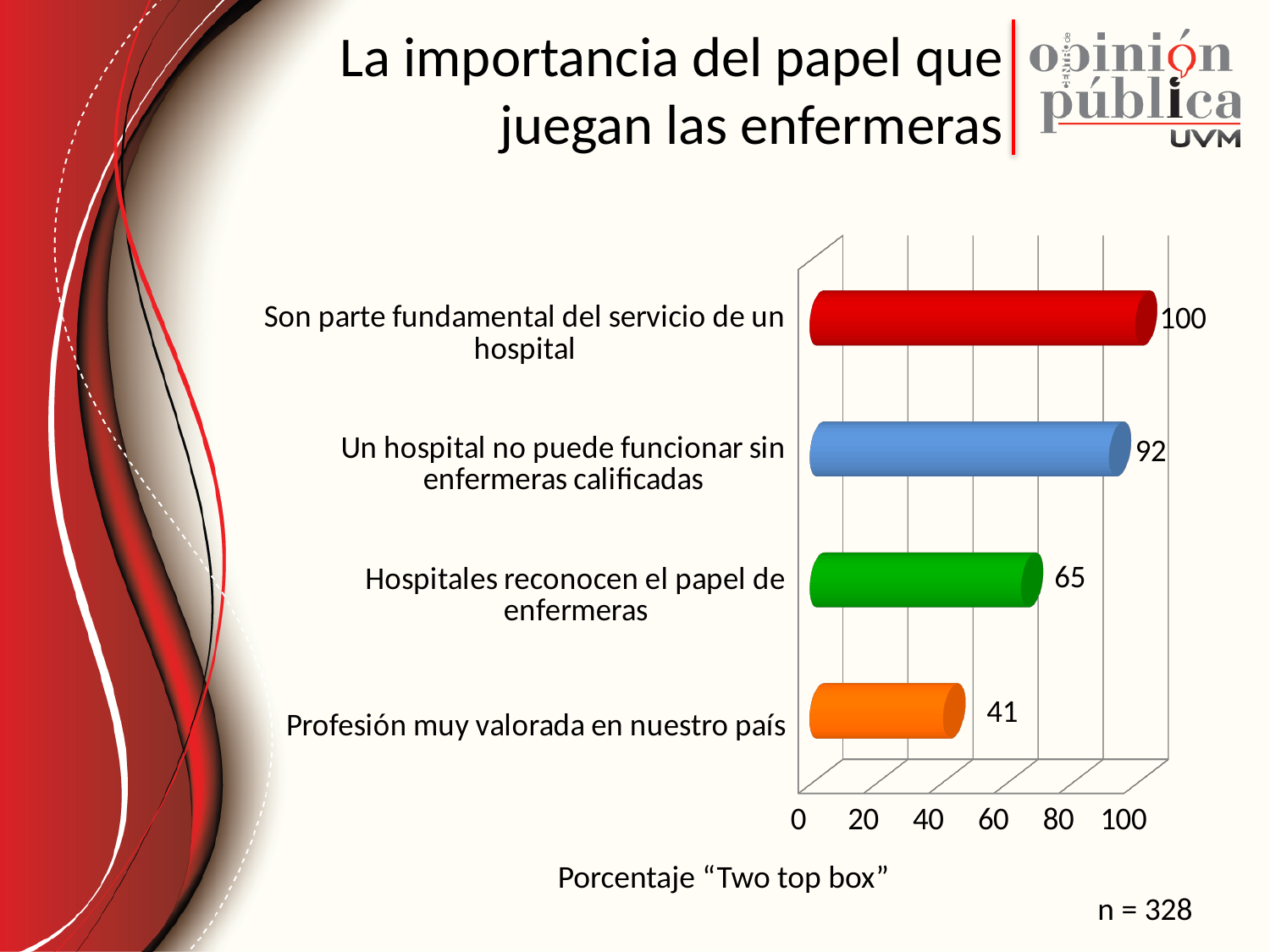
What is the value for "Hospitales reconocen el papel de enfermeras"? 65 Which is larger: the value for "Hospitales reconocen el papel de enfermeras" or the value for "Profesión muy valorada en nuestro país"? Hospitales reconocen el papel de enfermeras Which category has the highest value? Son parte fundamental del servicio de un hospital Which category has the lowest value? Profesión muy valorada en nuestro país What is the sample size (n) shown on the slide? 328 What is the difference between the values for "Son parte fundamental del servicio de un hospital" and "Profesión muy valorada en nuestro país"? 59 What is the value for "Profesión muy valorada en nuestro país"? 41 What is the value for "Un hospital no puede funcionar sin enfermeras calificadas"? 92 What is the difference between the values for "Un hospital no puede funcionar sin enfermeras calificadas" and "Hospitales reconocen el papel de enfermeras"? 27 What is the value for "Son parte fundamental del servicio de un hospital"? 100 How many categories are shown in the chart? 4 What kind of chart is shown on the slide? Bar chart